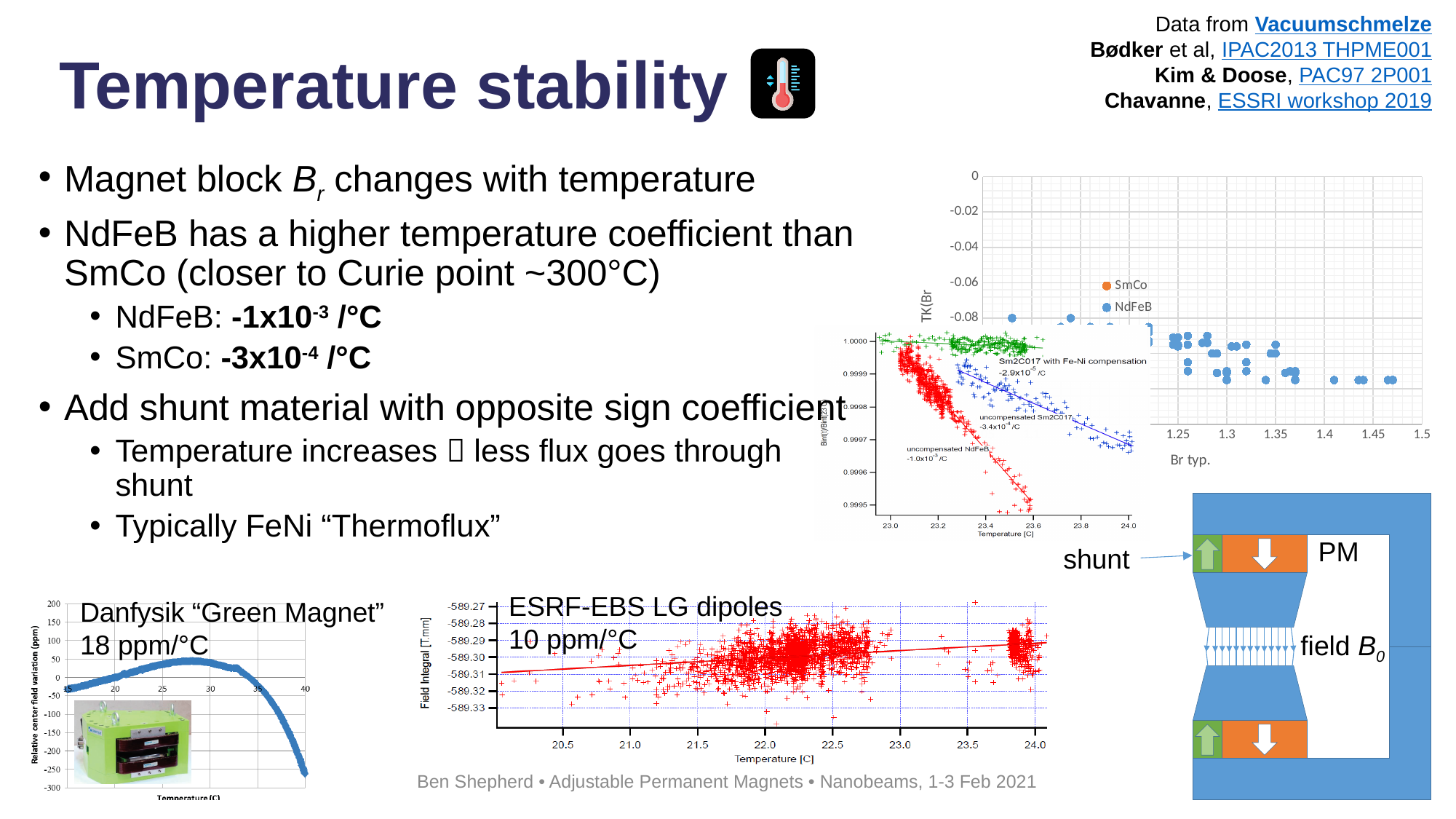
What is the difference between the printed temperature coefficients of the Danfysik "Green Magnet" (18 ppm/°C) and the ESRF-EBS LG dipoles (10 ppm/°C)? 8 ppm/°C In the inset chart of Bint versus Temperature [C], what temperature coefficient is printed for the uncompensated Sm2Co17 series? -3.4x10^-4 /C In the top-right scatter chart of TK(Br) versus Br typ., what are the two series named in the legend? SmCo and NdFeB In the inset chart of Bint versus Temperature [C], what temperature coefficient is printed for the Sm2Co17 with Fe-Ni compensation series? -2.9x10^-5 /C What kind of chart is the top-right chart of TK(Br) versus Br typ.? scatter chart In the inset chart of Bint versus Temperature [C], what temperature coefficient is printed for the uncompensated NdFeB series? -1.0x10^-3 /C In the ESRF-EBS LG dipoles chart, does the fitted field integral rise or fall as temperature increases from 20.5 to 24.0? rise What temperature coefficient in ppm/°C is printed on the ESRF-EBS LG dipoles chart? 10 ppm/°C In the top-right scatter chart of TK(Br) versus Br typ., how many series does the legend list? 2 In the inset chart of Bint versus Temperature [C], which series falls most steeply as temperature increases? uncompensated NdFeB What temperature coefficient in ppm/°C is printed on the Danfysik "Green Magnet" chart? 18 ppm/°C Which has the larger printed temperature coefficient, the Danfysik "Green Magnet" or the ESRF-EBS LG dipoles? Danfysik "Green Magnet"